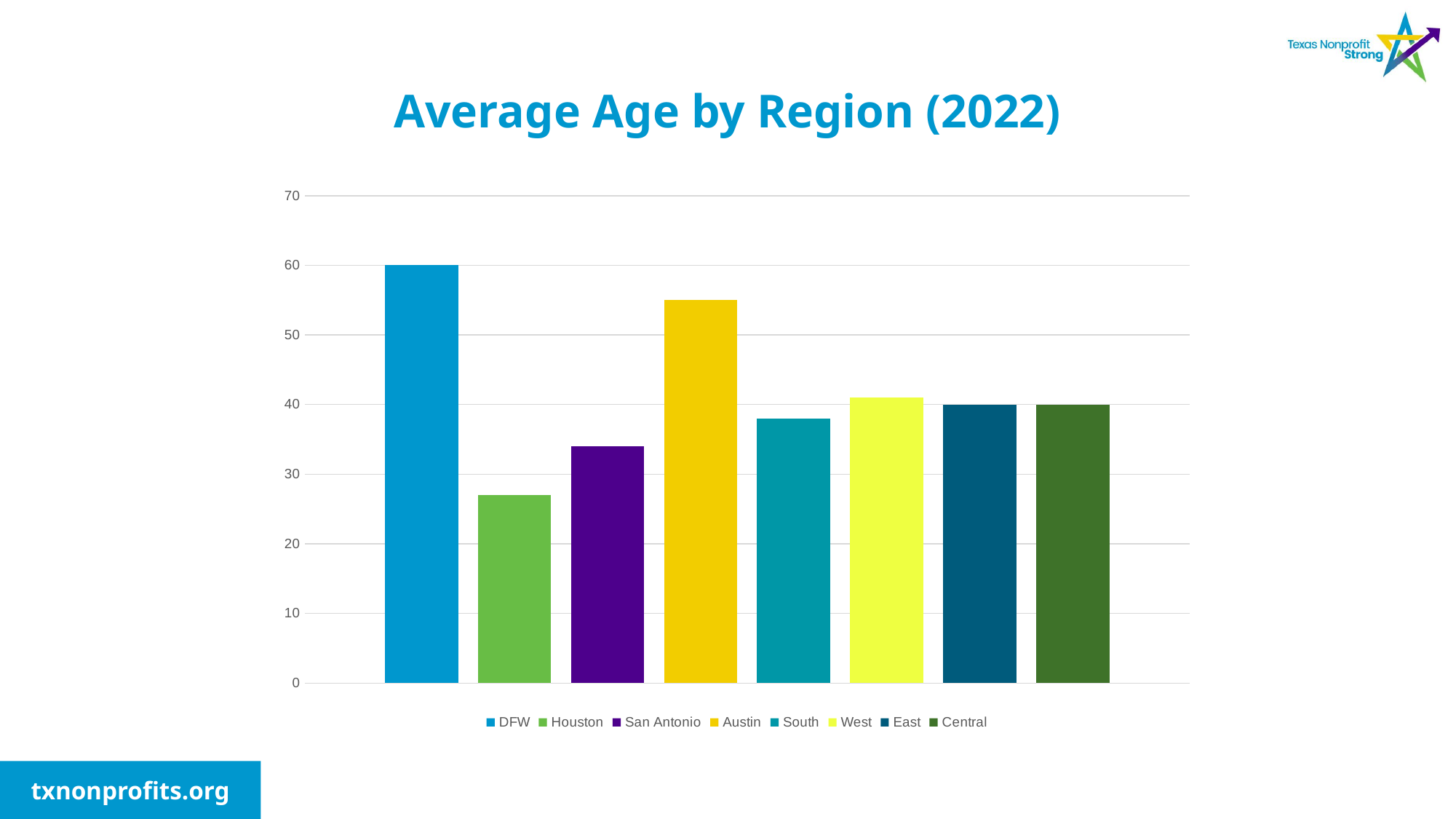
Is the value for Austin greater or less than 50? greater How many regions are plotted in the chart? 8 Which has a higher average age, Austin or South? Austin Which has a higher average age, San Antonio or Houston? San Antonio Which region has the lowest average age? Houston Which region has the highest average age? DFW Is the value for South greater or less than 40? less What kind of chart is shown on the slide? bar chart What is the title of the chart? Average Age by Region (2022) Is the value for Houston greater or less than 30? less What colour is the bar for Austin? yellow How many entries does the legend list? 8